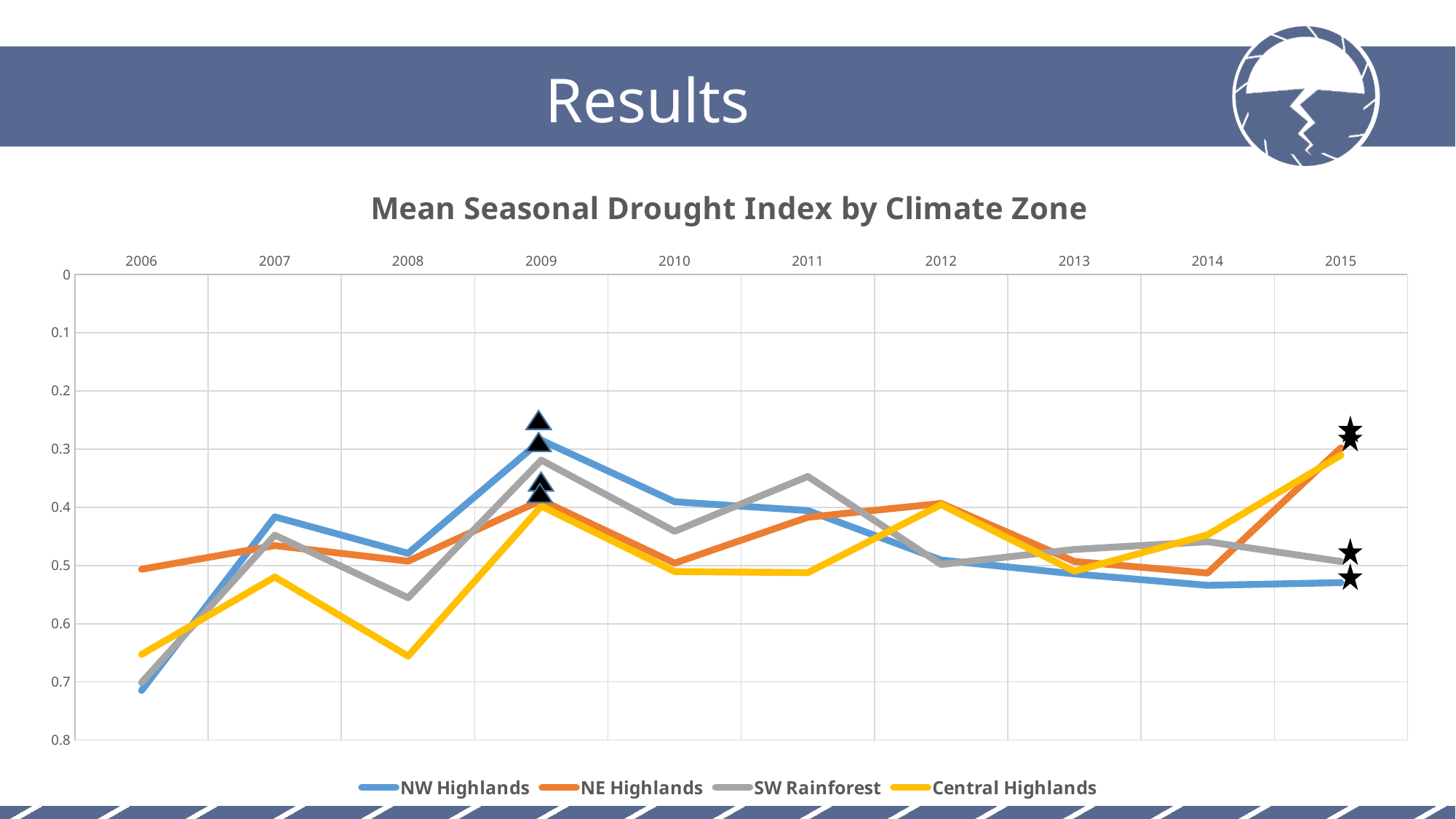
Is the value for NE Highlands in 2015 greater or less than 0.4? less How many series does the legend list? 4 Is the value for NW Highlands in 2009 greater or less than 0.4? less What kind of chart is shown on the slide? line chart Is the value for Central Highlands in 2008 greater or less than 0.6? greater In 2008, which series has the larger value, Central Highlands or NW Highlands? Central Highlands Which colour represents SW Rainforest in the legend? gray Do the values for Central Highlands increase or decrease from 2013 to 2015? decrease In which year does NW Highlands reach its lowest value? 2009 What is the title of the chart? Mean Seasonal Drought Index by Climate Zone How many years are plotted along the x axis? 10